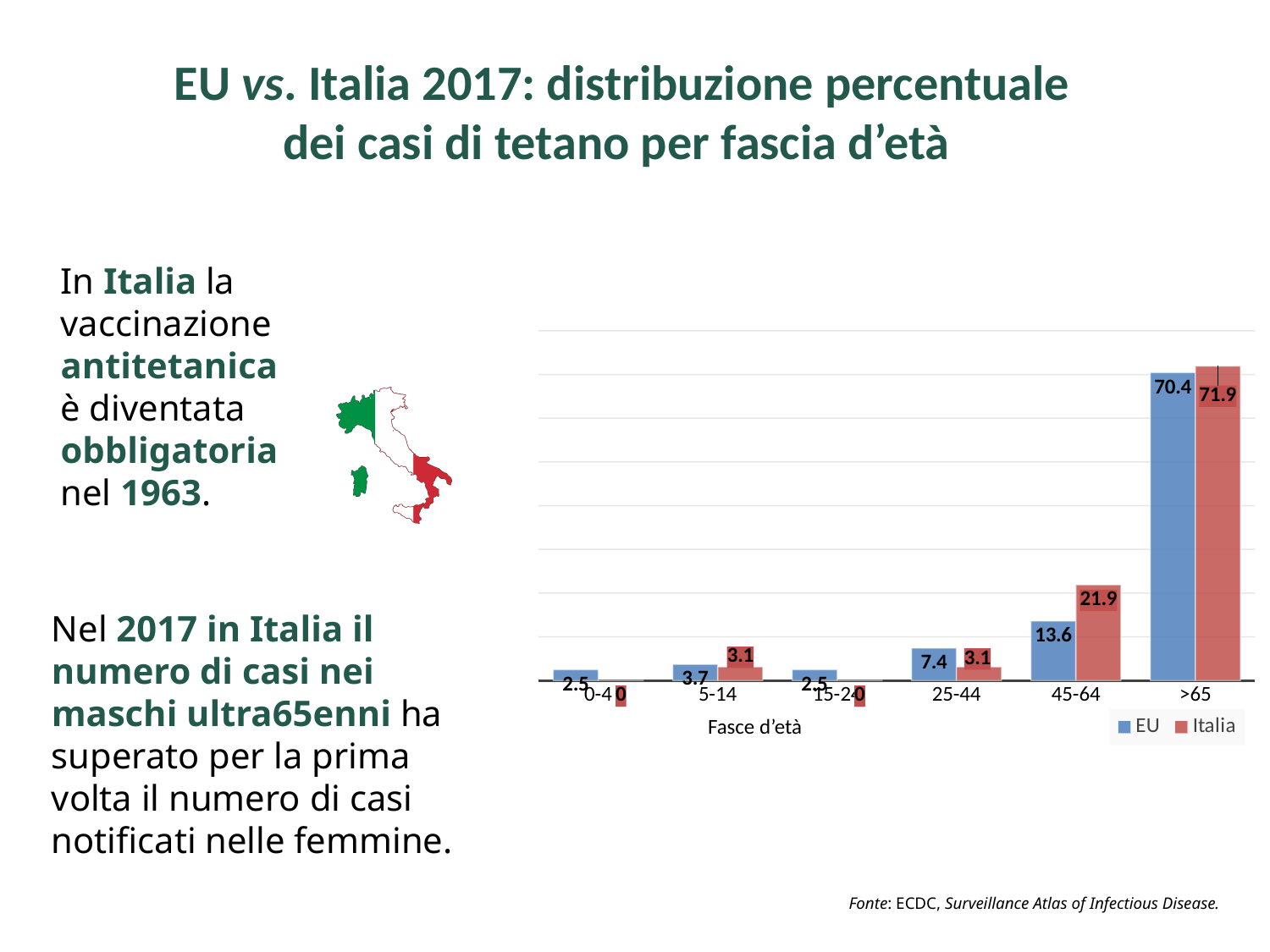
What is the difference between the Italia and EU values for the 45-64 age group? 8.3 For the 25-44 age group, which is larger, the EU value or the Italia value? EU What is the difference between the Italia and EU values for the >65 age group? 1.5 How many age groups are shown on the x axis? 6 What is the Italia value for the 45-64 age group? 21.9 What is the Italia value for the 0-4 age group? 0 What kind of chart is shown on the slide? Bar chart Which age group has the highest EU value? >65 What is the EU value for the >65 age group? 70.4 What is the EU value for the 25-44 age group? 7.4 How many series does the legend list? 2 Which age group has the highest Italia value? >65